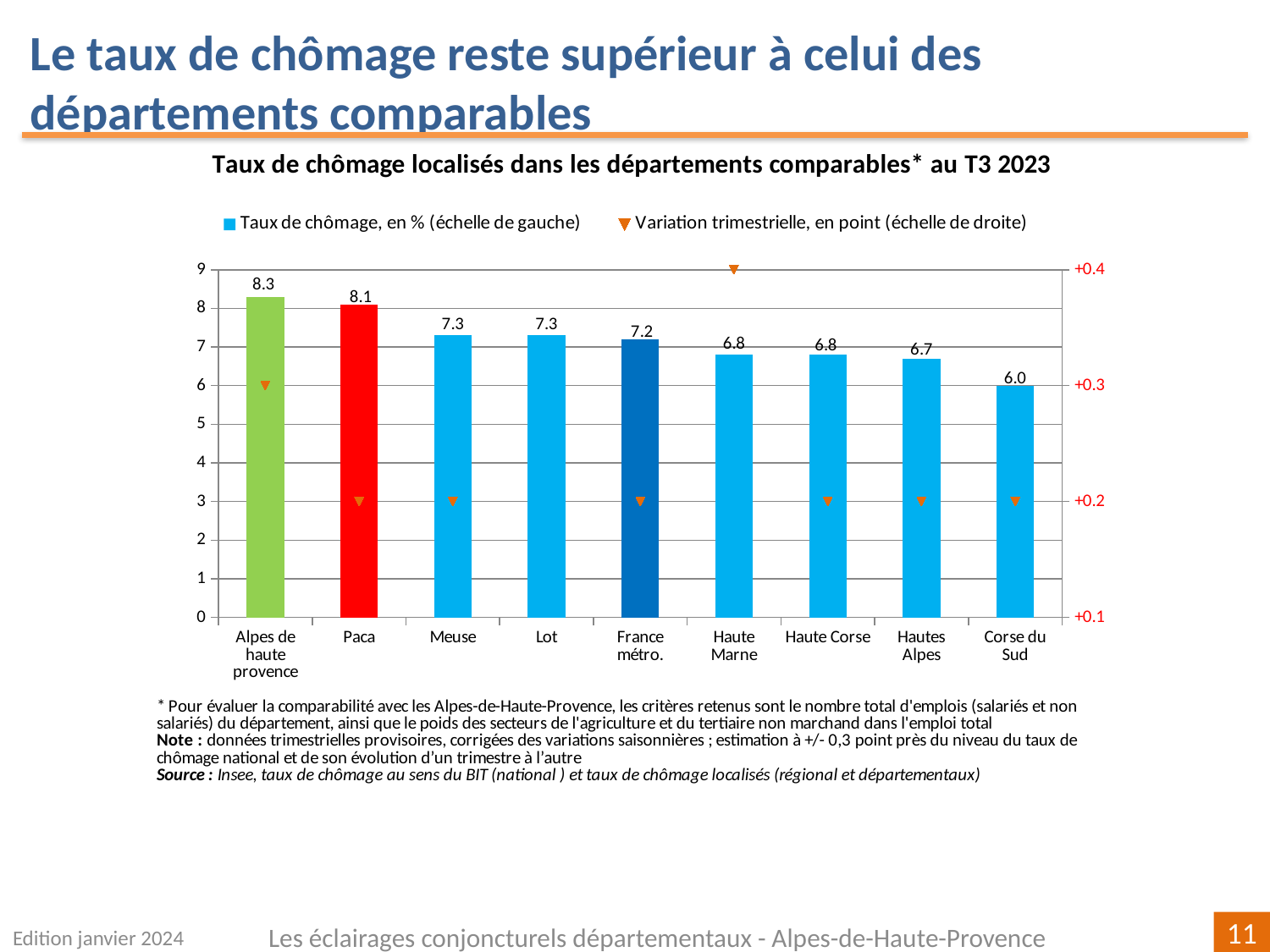
Which has a higher unemployment rate, Paca or Meuse? Paca What is the title of the chart? Taux de chômage localisés dans les départements comparables* au T3 2023 What is the quarterly variation (variation trimestrielle) marker value for Haute Marne on the right axis? +0.4 Which category has the lowest unemployment rate? Corse du Sud What is the unemployment rate (taux de chômage) shown for Alpes de haute provence? 8.3 What is the unemployment rate shown for France métro.? 7.2 What kind of chart is used for the unemployment rates? Bar chart How many categories are shown on the x axis? 9 How many series does the legend list? 2 What is the difference between the unemployment rates of Alpes de haute provence and Paca? 0.2 Which category has the highest unemployment rate? Alpes de haute provence What is the unemployment rate shown for Corse du Sud? 6.0